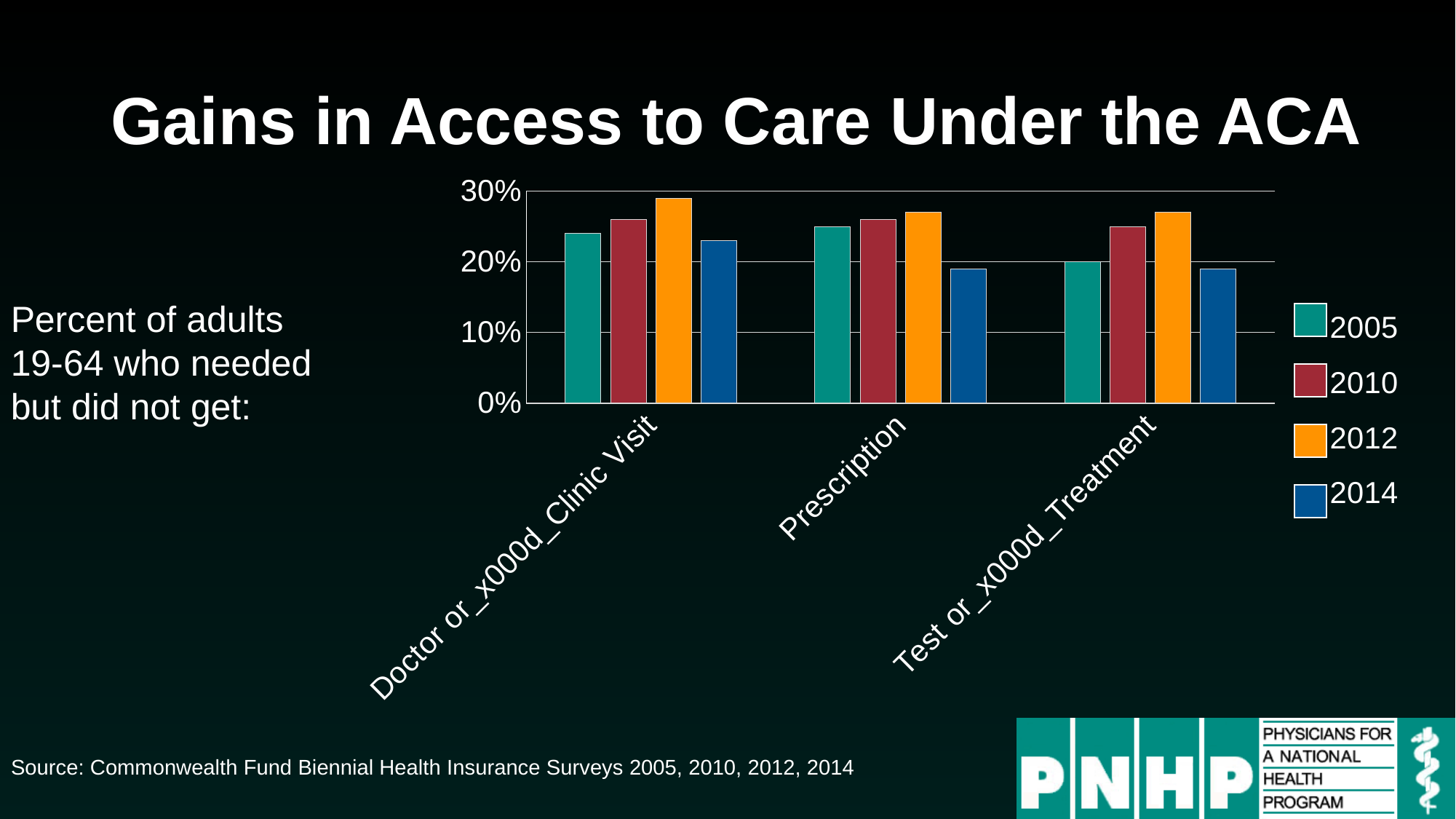
For Test or Treatment, which is larger: the 2005 value or the 2010 value? 2010 Is the 2014 value for Doctor or Clinic Visit greater or less than 20%? greater How many series does the chart's legend list? 4 Which year has the highest value for Doctor or Clinic Visit? 2012 For Doctor or Clinic Visit, do the values rise or fall from 2005 through 2010 to 2012? rise For Doctor or Clinic Visit, which is larger: the 2012 value or the 2014 value? 2012 What kind of chart is shown on the slide? bar chart What colour represents the 2012 series in the legend? orange Which year has the lowest value for Prescription? 2014 Is the 2012 value for Prescription greater or less than 20%? greater Which year has the highest value for Test or Treatment? 2012 How many categories are shown on the x axis of the chart? 3